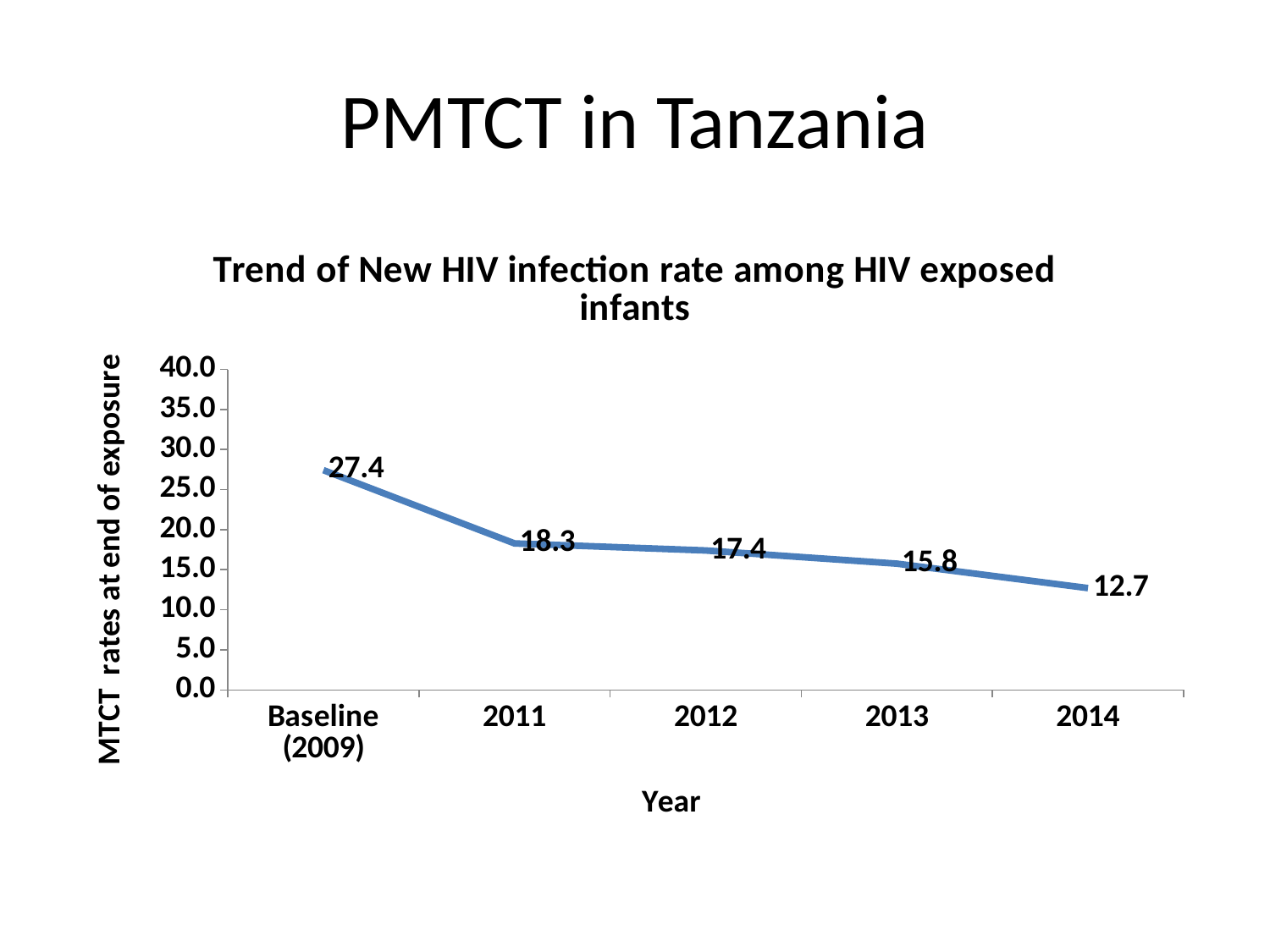
Which year has the lowest MTCT rate? 2014 How many data points are plotted on the chart? 5 Which is larger, the MTCT rate in 2011 or in 2013? 2011 What is the difference between the MTCT rate at Baseline (2009) and in 2011? 9.1 Do the MTCT rates rise or fall from Baseline (2009) to 2014? Fall Which year has the highest MTCT rate? Baseline (2009) What is the MTCT rate at the Baseline (2009)? 27.4 What is the difference between the MTCT rate in 2013 and in 2014? 3.1 What is the MTCT rate in 2014? 12.7 What kind of chart is shown on the slide? Line chart What is the MTCT rate in 2012? 17.4 Is the MTCT rate in 2012 greater or less than 20.0? less